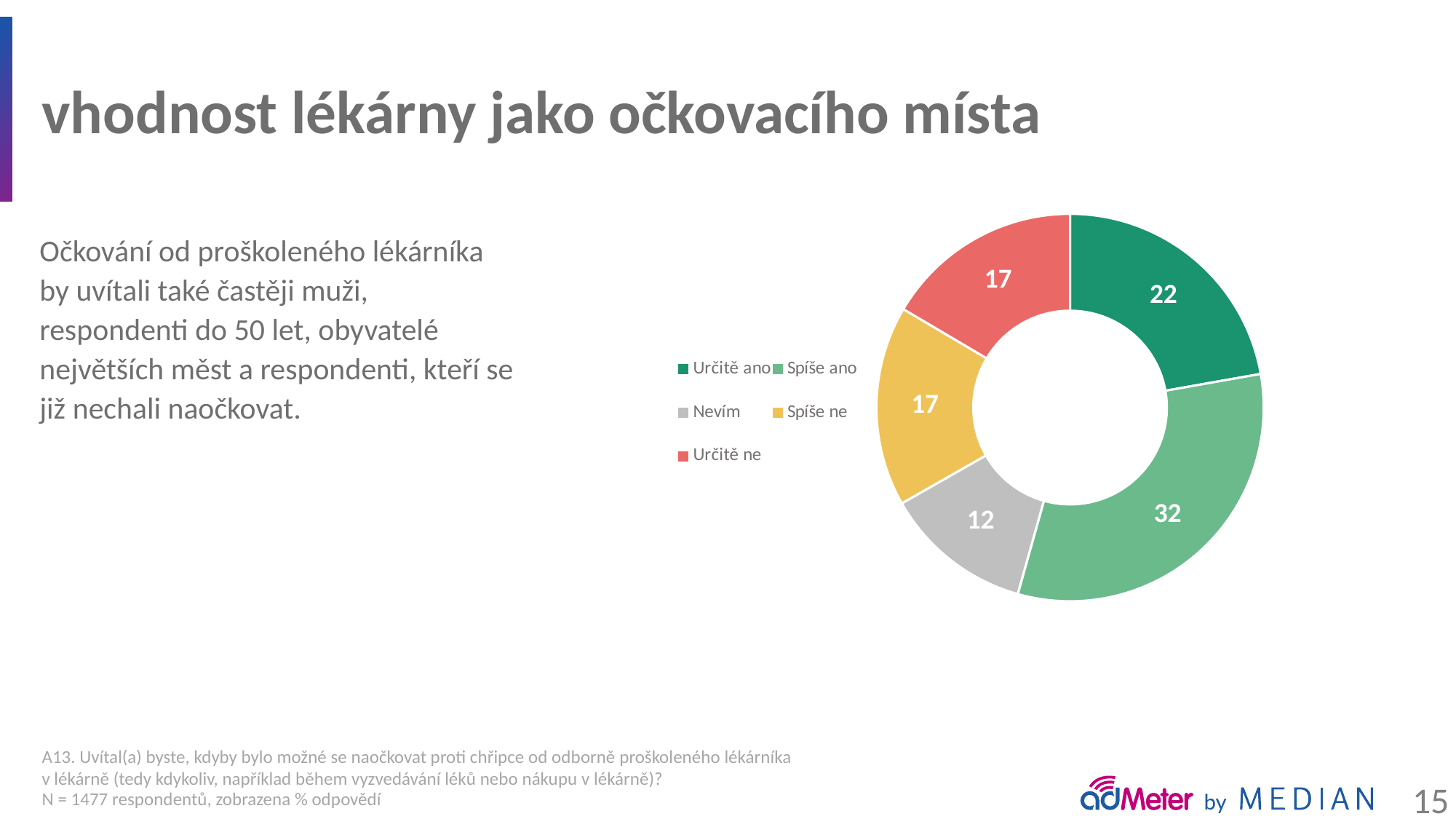
How many categories does the chart show? 5 Which category has the largest slice? Spíše ano What is the difference between the values for "Spíše ano" and "Určitě ano"? 10 What is the sum of all the values shown in the chart? 100 What is the value shown for "Spíše ano"? 32 What is the value shown for "Určitě ano"? 22 What is the value shown for "Nevím"? 12 What kind of chart is shown on the slide? Doughnut (pie) chart Which is larger, the value for "Určitě ano" or the value for "Nevím"? Určitě ano Which category has the smallest slice? Nevím What is the value shown for "Spíše ne"? 17 What colour is the "Určitě ne" slice? Red